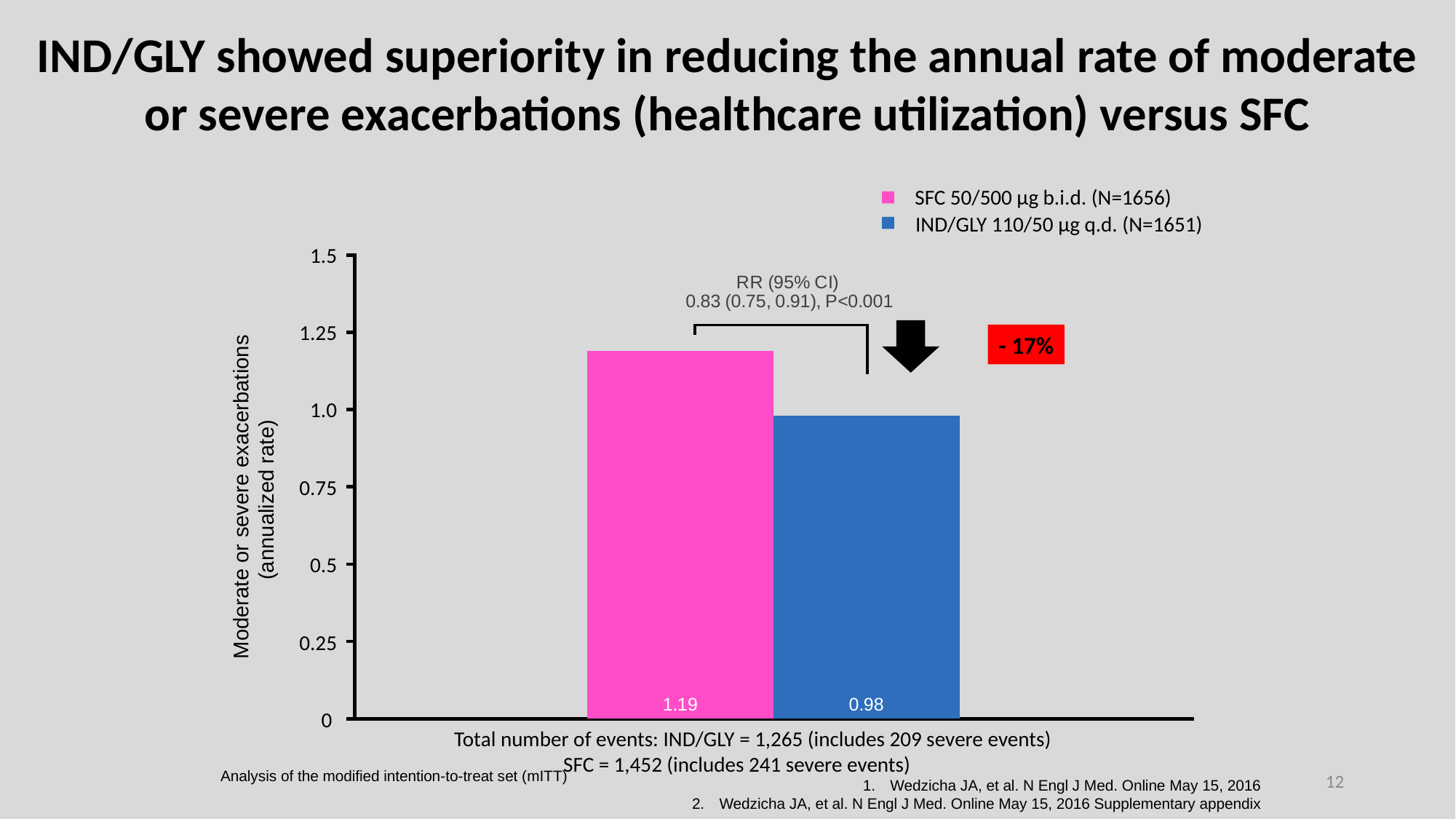
Which treatment has the higher annualized exacerbation rate? SFC 50/500 µg b.i.d. What percentage reduction is shown in the red box on the chart? - 17% How many series does the legend list? 2 How many bars are plotted in the chart? 2 What is the annualized rate of moderate or severe exacerbations for IND/GLY 110/50 µg q.d.? 0.98 What type of chart is shown on the slide? Bar chart What colour is the bar for IND/GLY 110/50 µg q.d.? Blue What is the difference between the SFC and IND/GLY annualized exacerbation rates? 0.21 Is the annualized exacerbation rate for IND/GLY greater or less than 1.0? less What is the annualized rate of moderate or severe exacerbations for SFC 50/500 µg b.i.d.? 1.19 Is the annualized exacerbation rate for SFC greater or less than 1.0? greater Which treatment has the lower annualized exacerbation rate? IND/GLY 110/50 µg q.d.